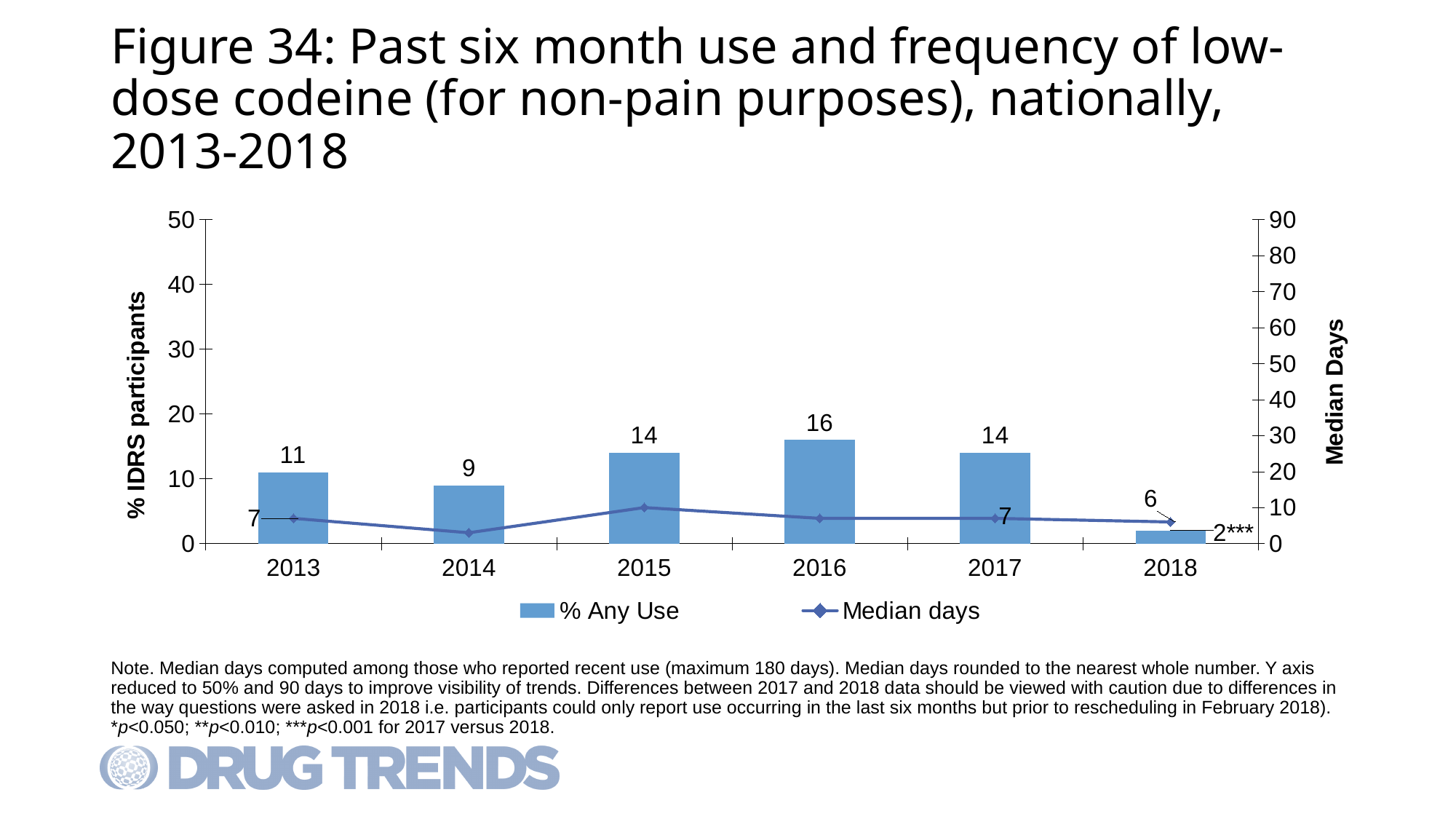
Which year has the lowest % Any Use? 2018 What is the % Any Use value for 2014? 9 What kind of chart is this? Combined bar and line chart What is the difference in % Any Use between 2016 and 2018? 14 Is the Median days value for 2014 greater or less than 10? less Does % Any Use rise or fall from 2016 to 2018? fall Which year has the highest % Any Use? 2016 What is the % Any Use value for 2016? 16 Which year has the larger % Any Use, 2013 or 2015? 2015 How many series does the legend list? 2 What is the Median days value for 2018? 6 How many years are shown on the x axis? 6